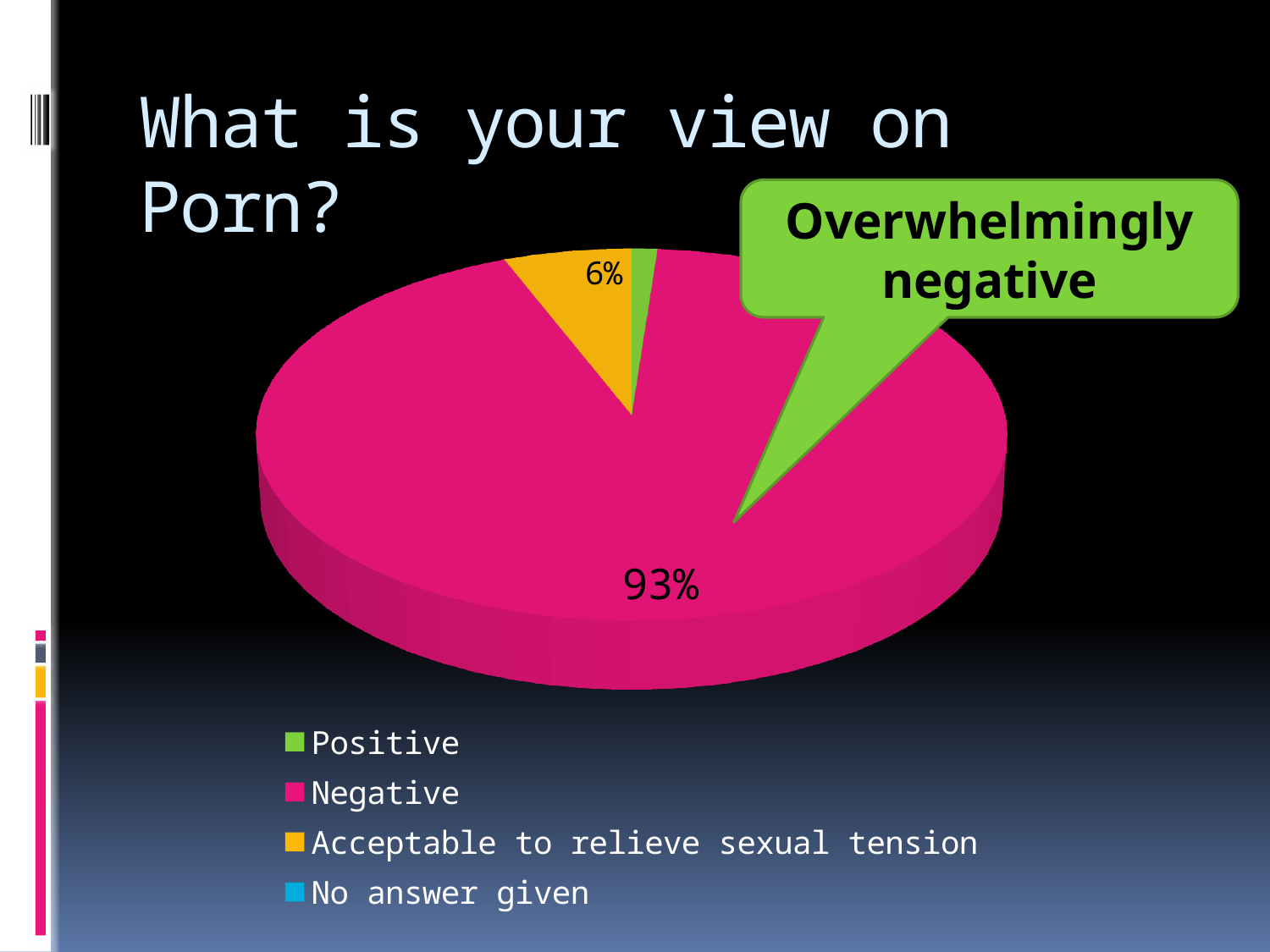
What is the title of the slide containing the pie chart? What is your view on Porn? What is the difference in percentage points between the Negative share and the Acceptable to relieve sexual tension share? 87 What percentage of respondents said porn is acceptable to relieve sexual tension? 6% What percentage of respondents gave a Negative view on porn? 93% What does the green callout next to the pie chart say? Overwhelmingly negative How many categories does the legend list? 4 Which is larger: the share for Negative or the share for Acceptable to relieve sexual tension? Negative What kind of chart is shown on the slide? pie chart Which response category has the largest share of the pie? Negative Is the share for Negative greater or less than 50%? greater